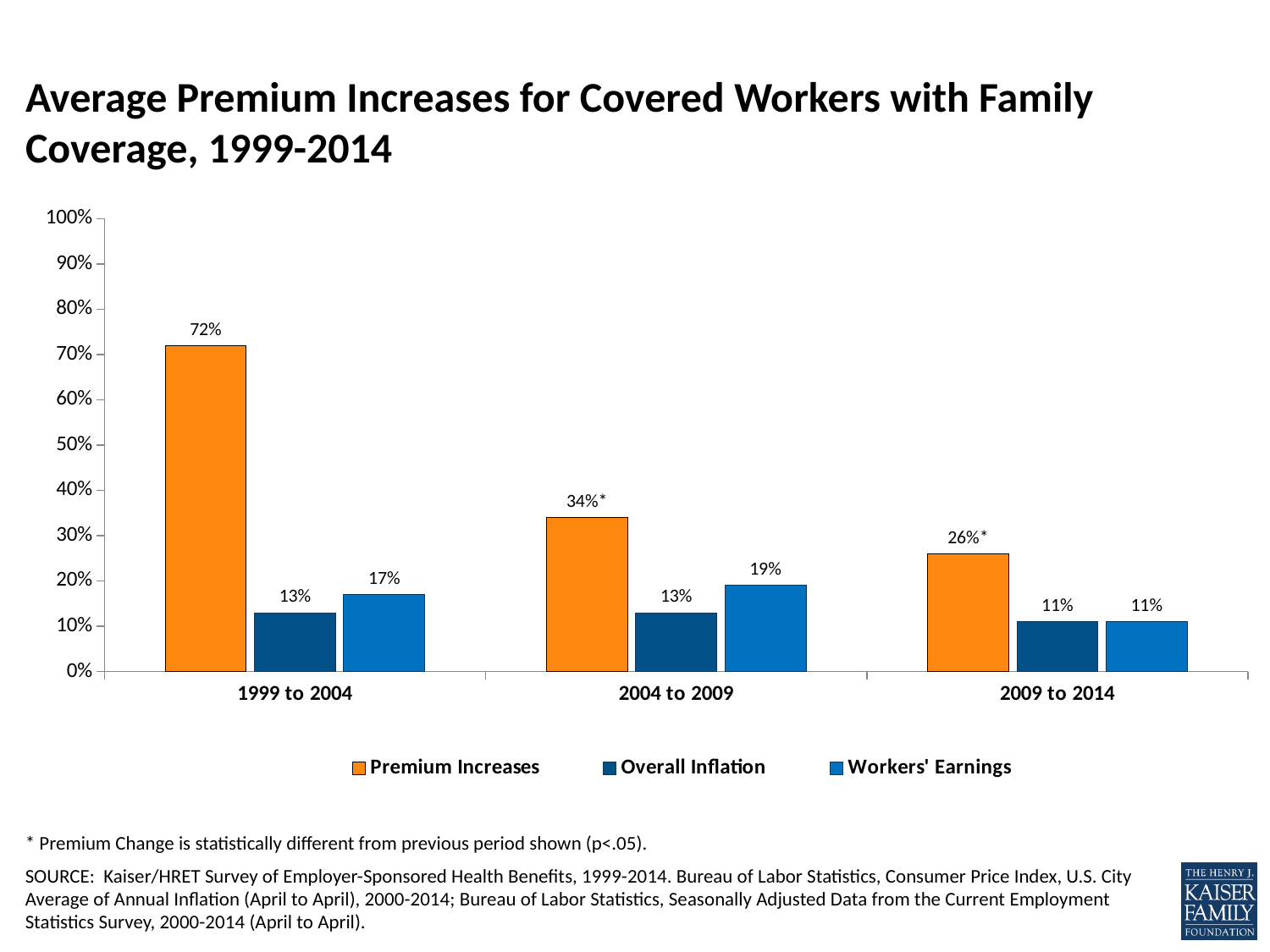
Do the Premium Increases values rise or fall across the periods from 1999 to 2004 through 2009 to 2014? Fall What is the Overall Inflation value for 2009 to 2014? 11% Which is larger for 2004 to 2009: Overall Inflation or Workers' Earnings? Workers' Earnings What is the Premium Increases value for 2004 to 2009? 34%* Which period has the highest Premium Increases value? 1999 to 2004 What kind of chart is shown on the slide? Bar chart How many series does the legend list? 3 How many periods are shown on the x axis? 3 What is the difference between Premium Increases and Workers' Earnings for 1999 to 2004? 55% What is the Workers' Earnings value for 2004 to 2009? 19% What is the Premium Increases value for 1999 to 2004? 72% Which period has the lowest Workers' Earnings value? 2009 to 2014